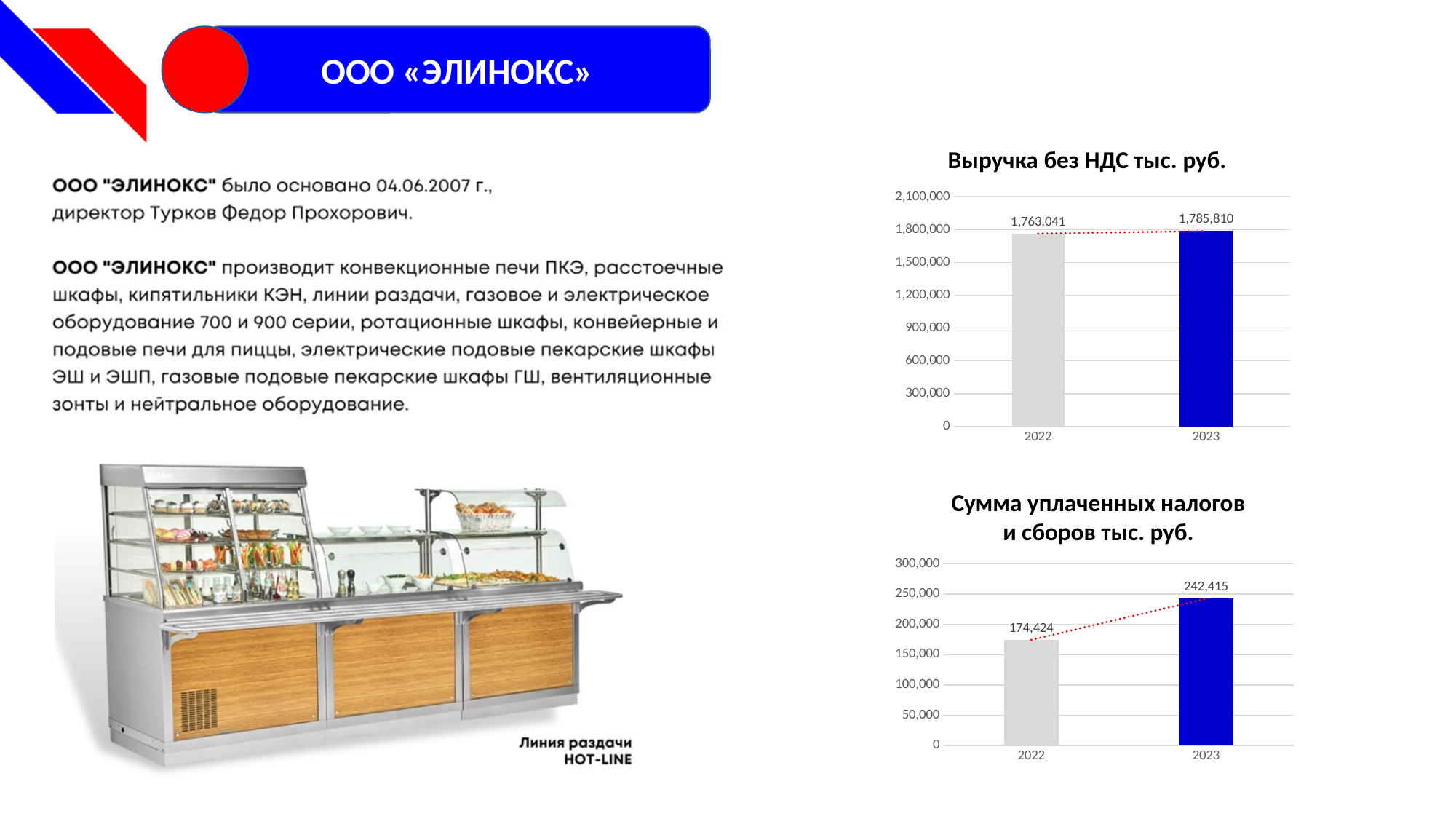
In the chart titled "Сумма уплаченных налогов и сборов тыс. руб.", what is the value for 2022? 174,424 In the chart titled "Выручка без НДС тыс. руб.", what is the value for 2022? 1,763,041 In the chart titled "Сумма уплаченных налогов и сборов тыс. руб.", is the value for 2022 greater or less than 200,000? less In the chart titled "Выручка без НДС тыс. руб.", what is the difference between the 2023 and 2022 values? 22,769 In the chart titled "Выручка без НДС тыс. руб.", which year has the lowest value? 2022 In the chart titled "Сумма уплаченных налогов и сборов тыс. руб.", what is the difference between the 2023 and 2022 values? 67,991 In the chart titled "Выручка без НДС тыс. руб.", what is the value for 2023? 1,785,810 In the chart titled "Сумма уплаченных налогов и сборов тыс. руб.", do the values rise or fall from 2022 to 2023? rise In the chart titled "Выручка без НДС тыс. руб.", how many years are shown on the x axis? 2 In the chart titled "Сумма уплаченных налогов и сборов тыс. руб.", what is the value for 2023? 242,415 What kind of chart is the chart titled "Сумма уплаченных налогов и сборов тыс. руб."? bar chart In the chart titled "Сумма уплаченных налогов и сборов тыс. руб.", which year has the highest value? 2023